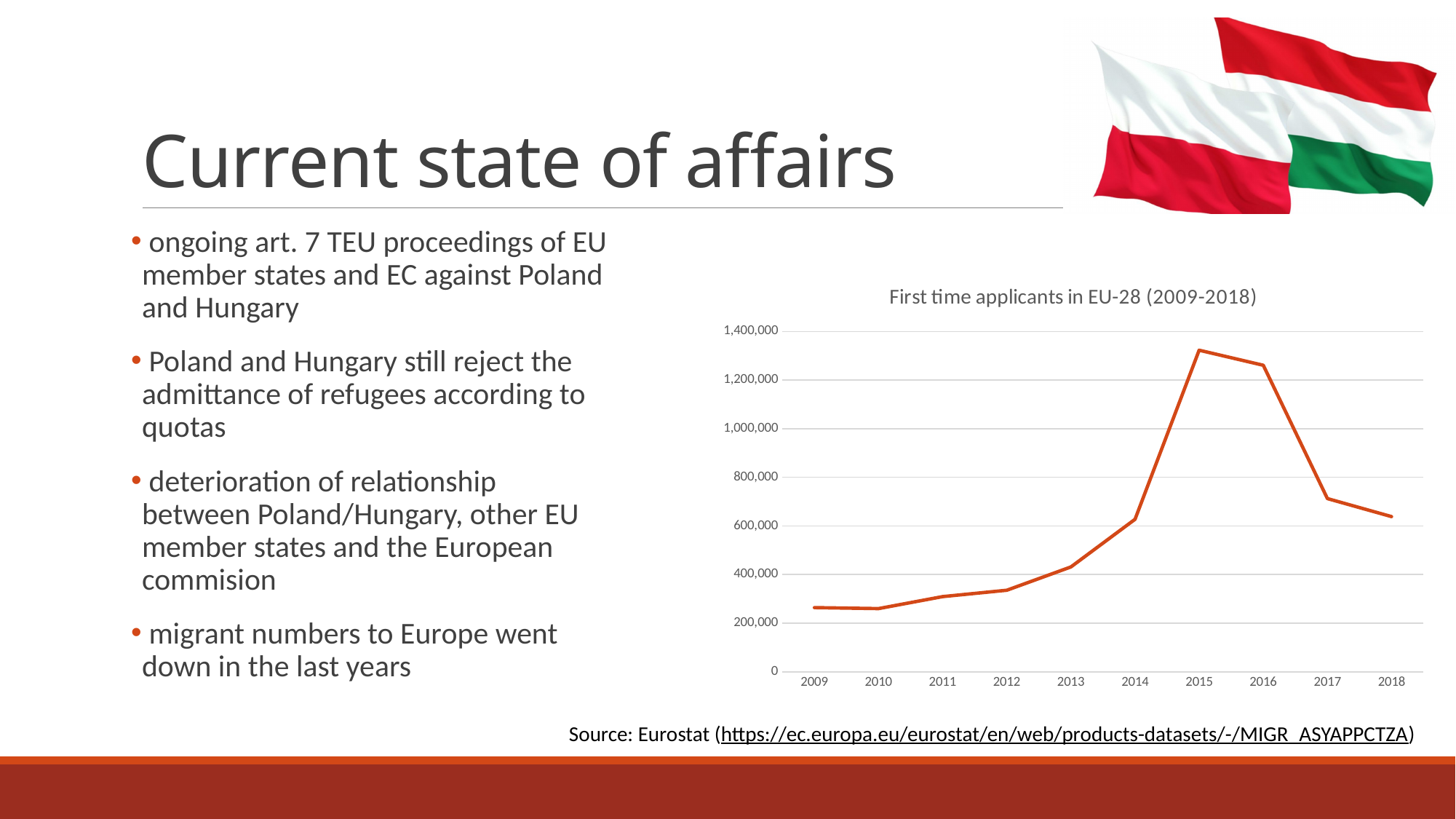
Is the value for 2014 greater or less than 600,000? greater In which year is the number of first time applicants highest? 2015 Is the value for 2009 greater or less than 200,000? greater Is the value for 2015 greater or less than 1,200,000? greater Do the values rise or fall from 2015 to 2018? fall Which year has the larger value, 2015 or 2016? 2015 What is the title of the chart? First time applicants in EU-28 (2009-2018) Which year has the larger value, 2017 or 2018? 2017 How many years are plotted on the x axis of the chart? 10 What kind of chart is shown on the slide? line chart